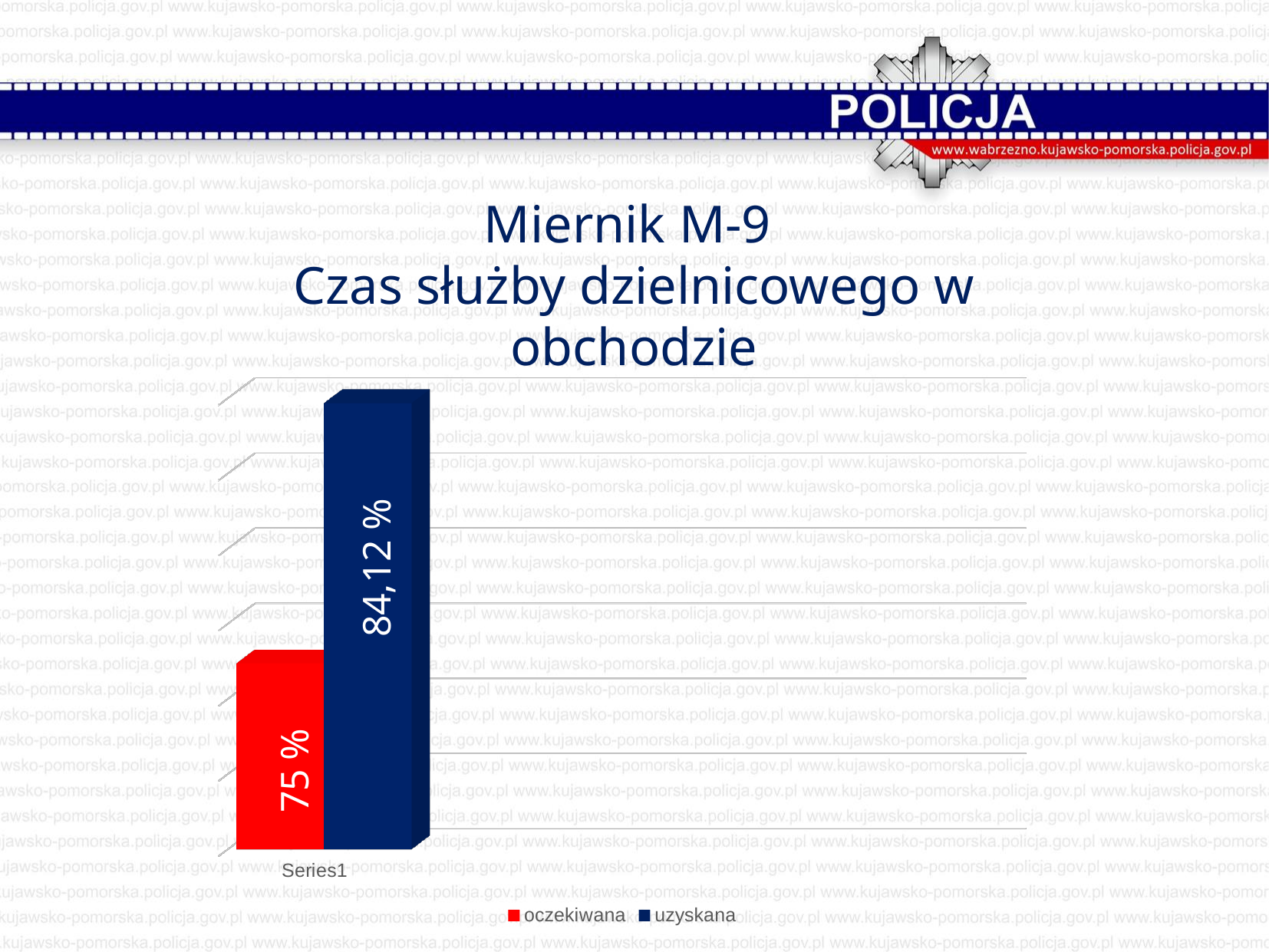
How many bars are plotted on the chart? 2 Which series has the lowest value on the chart? oczekiwana What is the value of the 'oczekiwana' bar? 75 % What is the category label shown under the bars? Series1 What colour is the 'oczekiwana' bar? red Which series has the higher value, 'oczekiwana' or 'uzyskana'? uzyskana Which series has the highest value on the chart? uzyskana What is the value of the 'uzyskana' bar? 84,12 % How many series does the legend list? 2 What kind of chart is shown on the slide? bar chart What is the difference between the 'uzyskana' value and the 'oczekiwana' value? 9,12 %